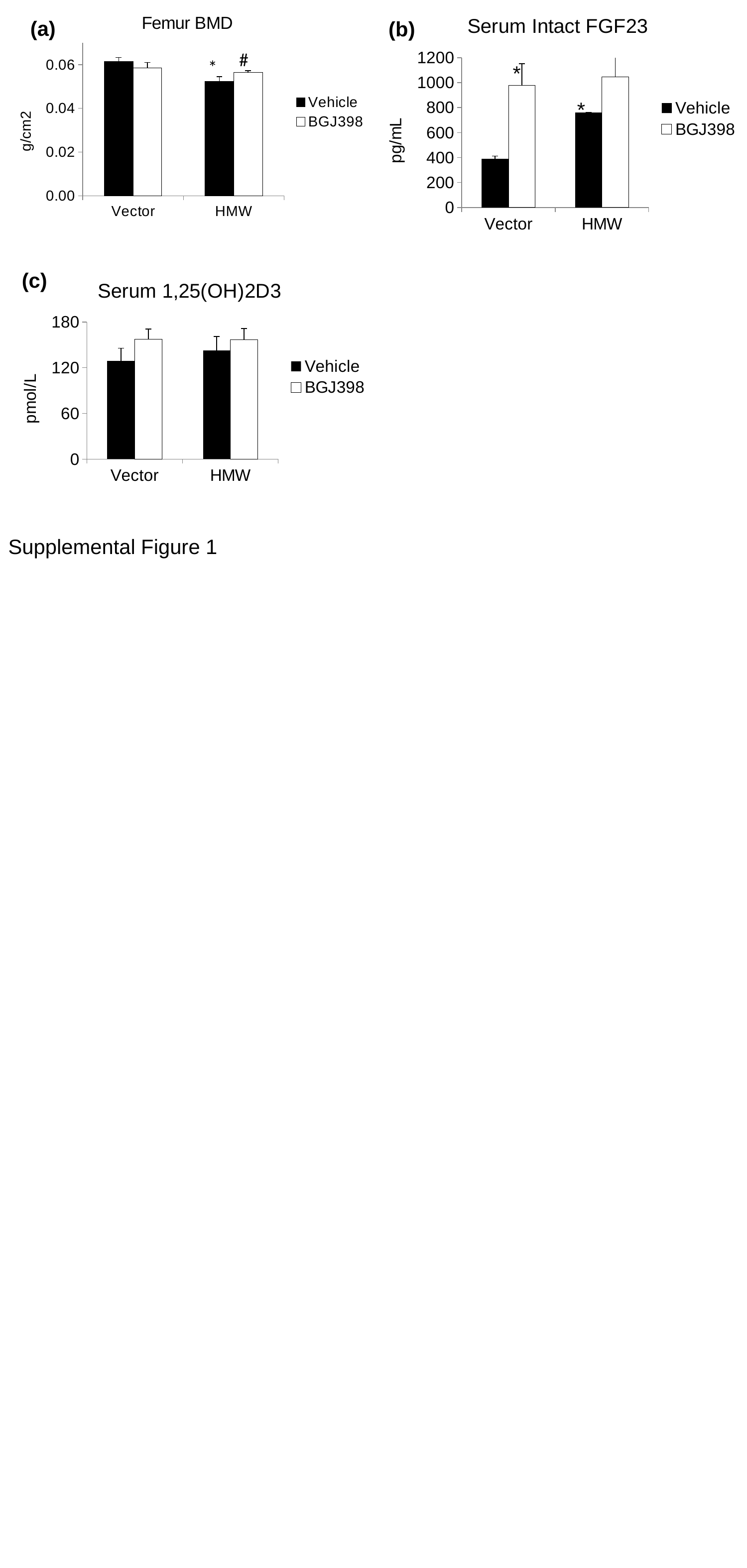
What is the y-axis unit label on the Serum 1,25(OH)2D3 chart? pmol/L In the Femur BMD chart, is the Vehicle value for HMW greater or less than 0.06? less In the Femur BMD chart, how many series does the legend list? 2 In the Femur BMD chart, which is larger, the Vehicle value for Vector or the Vehicle value for HMW? Vector In the Serum 1,25(OH)2D3 chart, is the Vehicle value for Vector greater or less than 120? greater What kind of chart is the Femur BMD chart? bar chart In the Serum Intact FGF23 chart, is the Vehicle value for Vector greater or less than 600? less In the Serum Intact FGF23 chart, which is larger for Vector, Vehicle or BGJ398? BGJ398 In the Serum 1,25(OH)2D3 chart, how many categories are shown on the x axis? 2 In the Serum Intact FGF23 chart, which bar is the lowest? Vehicle for Vector